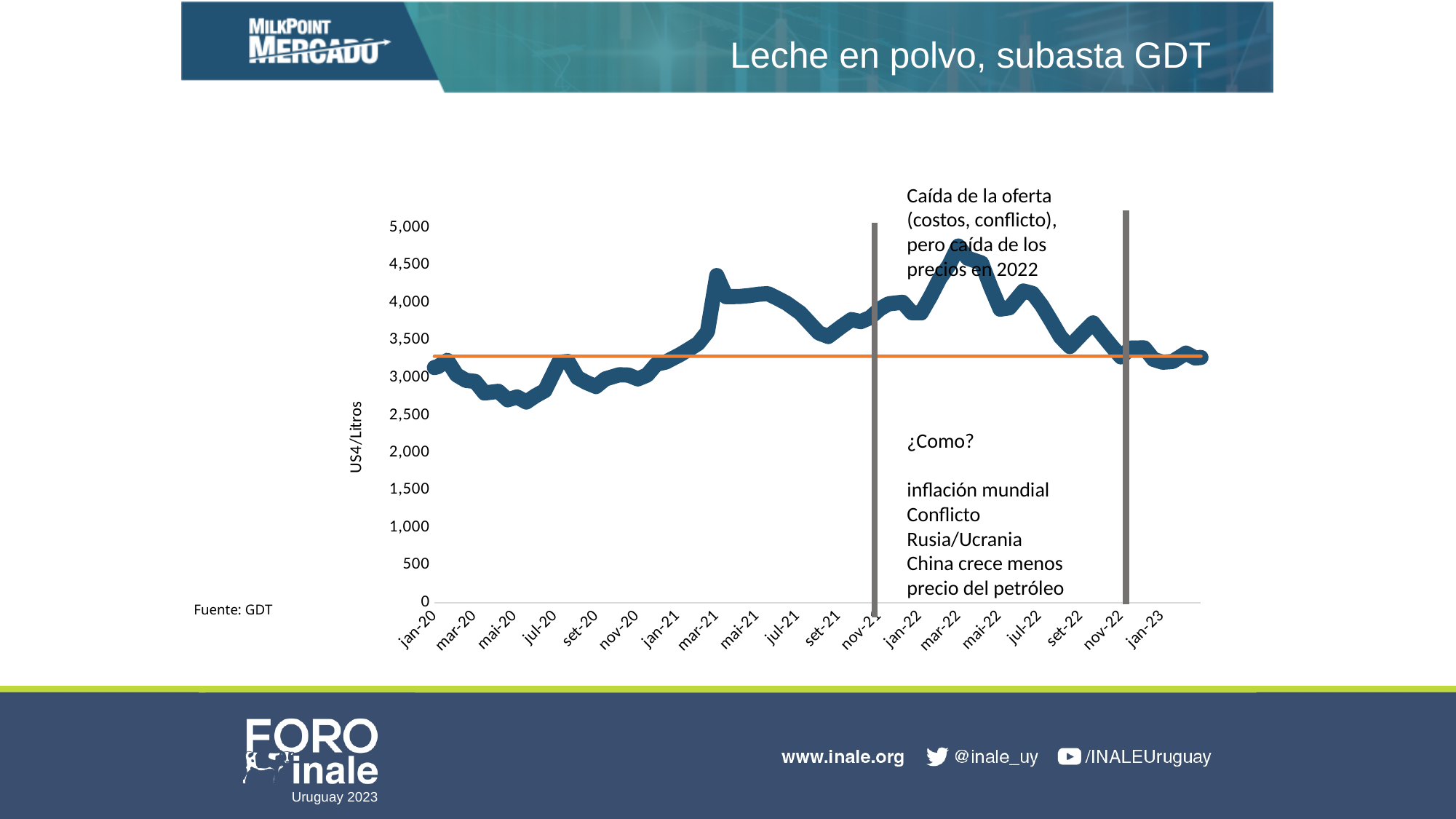
What is the source cited for the chart data? GDT Is the value for set-21 greater or less than 3,000? greater Does the line rise or fall between nov-20 and mar-21? rise In which year does the line reach its lowest value? 2020 Is the value for mai-20 greater or less than 3,000? less In which year does the line reach its highest value? 2022 Is the value for jan-20 greater or less than 3,500? less What kind of chart is shown on the slide? line chart Does the line rise or fall between jan-20 and mai-20? fall What is the title of the slide containing the chart? Leche en polvo, subasta GDT